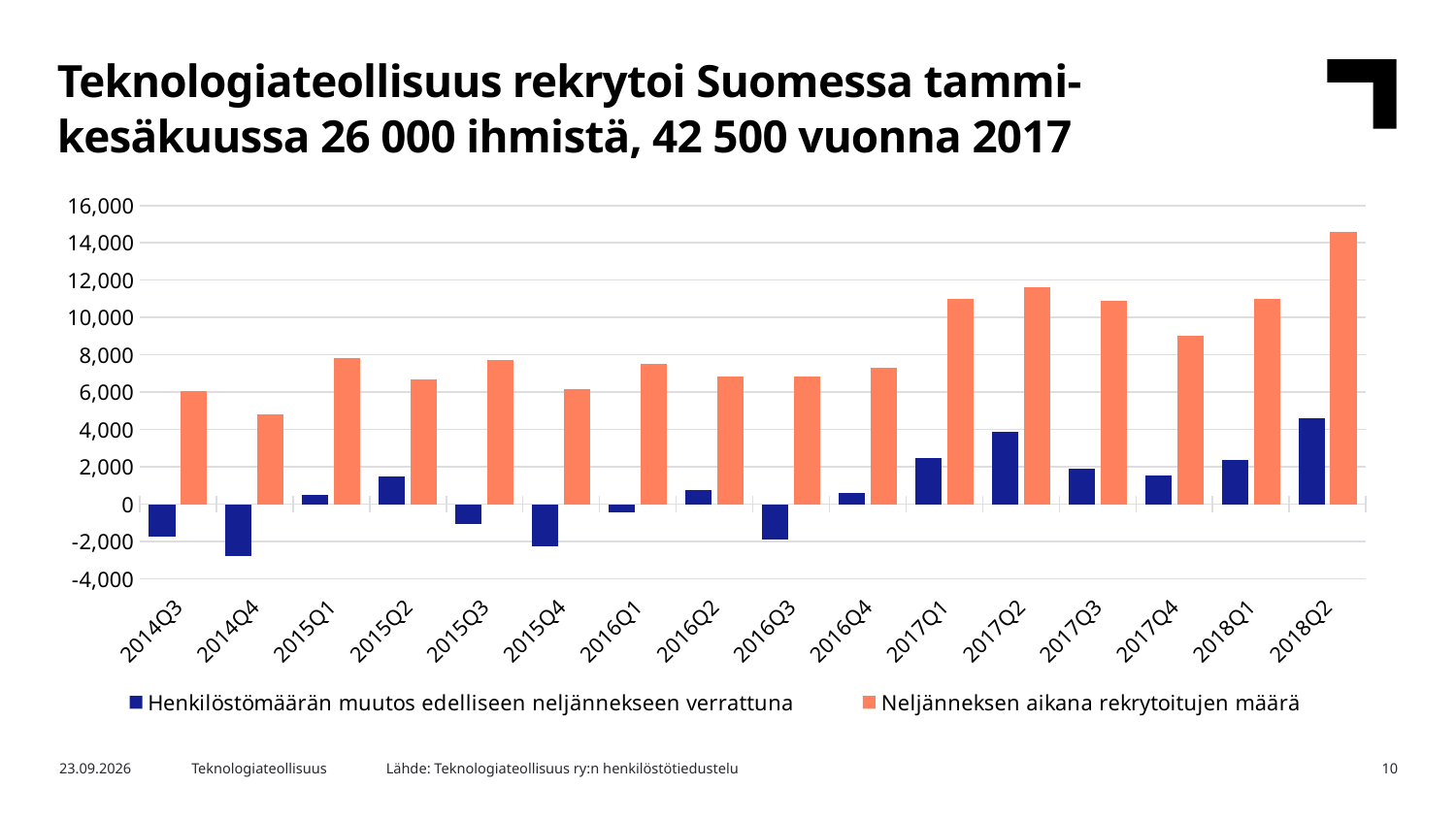
Which colour represents 'Neljänneksen aikana rekrytoitujen määrä' in the chart? Orange Is the value for 'Neljänneksen aikana rekrytoitujen määrä' in 2018Q2 greater or less than 14,000? greater How many series does the chart's legend list? 2 In which quarter is the value for 'Henkilöstömäärän muutos edelliseen neljännekseen verrattuna' lowest? 2014Q4 Which quarter has the larger value for 'Henkilöstömäärän muutos edelliseen neljännekseen verrattuna', 2017Q2 or 2017Q3? 2017Q2 In which quarter is the value for 'Neljänneksen aikana rekrytoitujen määrä' lowest? 2014Q4 Is the value for 'Neljänneksen aikana rekrytoitujen määrä' in 2017Q4 greater or less than 10,000? less In which quarter is the value for 'Neljänneksen aikana rekrytoitujen määrä' highest? 2018Q2 In which quarter is the value for 'Henkilöstömäärän muutos edelliseen neljännekseen verrattuna' highest? 2018Q2 Which quarter has the larger value for 'Neljänneksen aikana rekrytoitujen määrä', 2016Q4 or 2017Q1? 2017Q1 How many quarters are shown on the x axis of the chart? 16 What kind of chart is shown on the slide? Bar chart